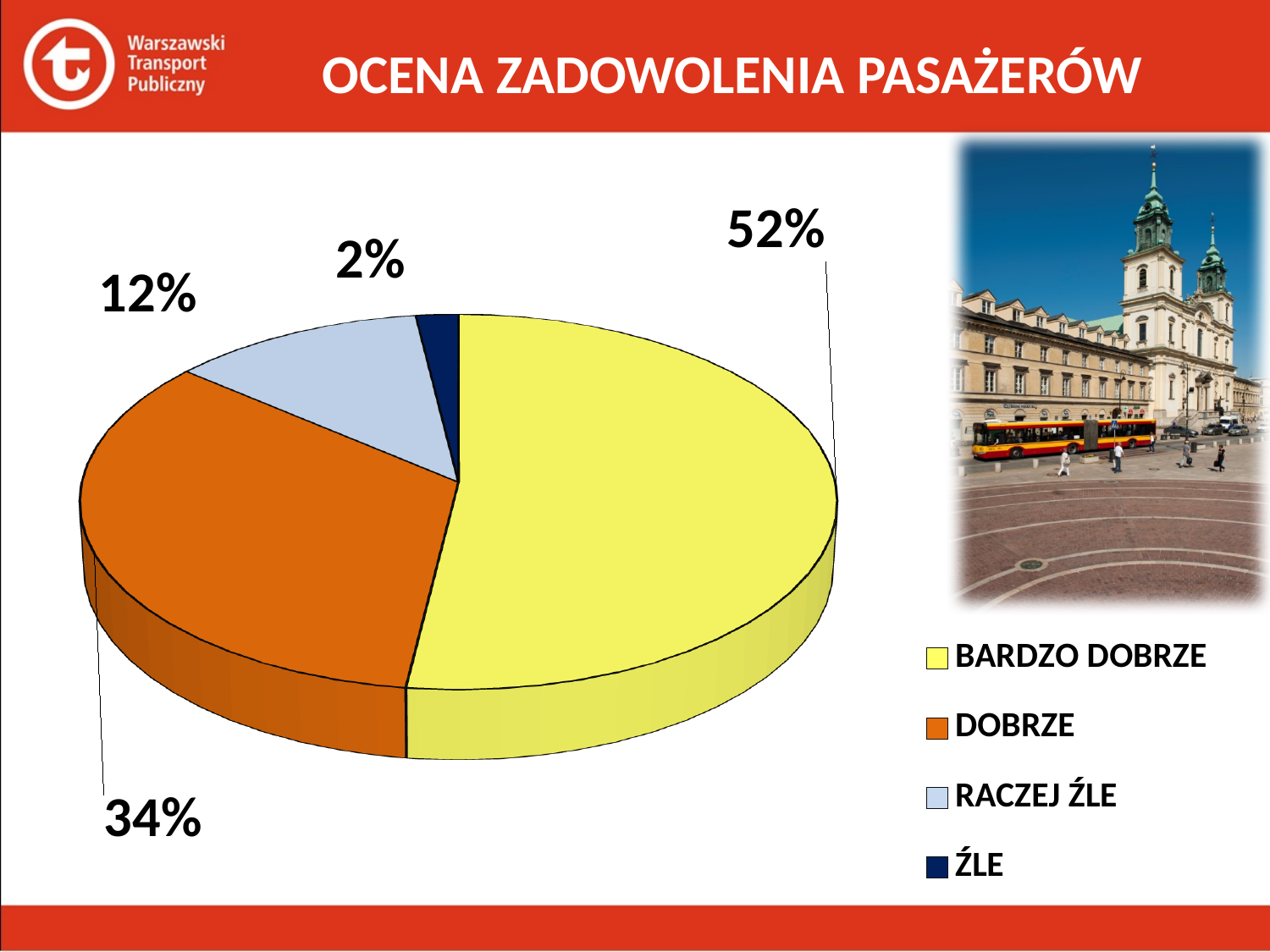
What share of the pie does ŹLE have? 2% How many categories does the pie chart show? 4 Which category has the smallest slice of the pie? ŹLE What is the combined share of BARDZO DOBRZE and DOBRZE? 86% What colour is the slice for DOBRZE? Orange What share of the pie does BARDZO DOBRZE have? 52% What kind of chart is shown on the slide? Pie chart Which is larger, the share for DOBRZE or the share for RACZEJ ŹLE? DOBRZE What share of the pie does DOBRZE have? 34% Which category has the largest slice of the pie? BARDZO DOBRZE What is the difference in percentage points between BARDZO DOBRZE and DOBRZE? 18